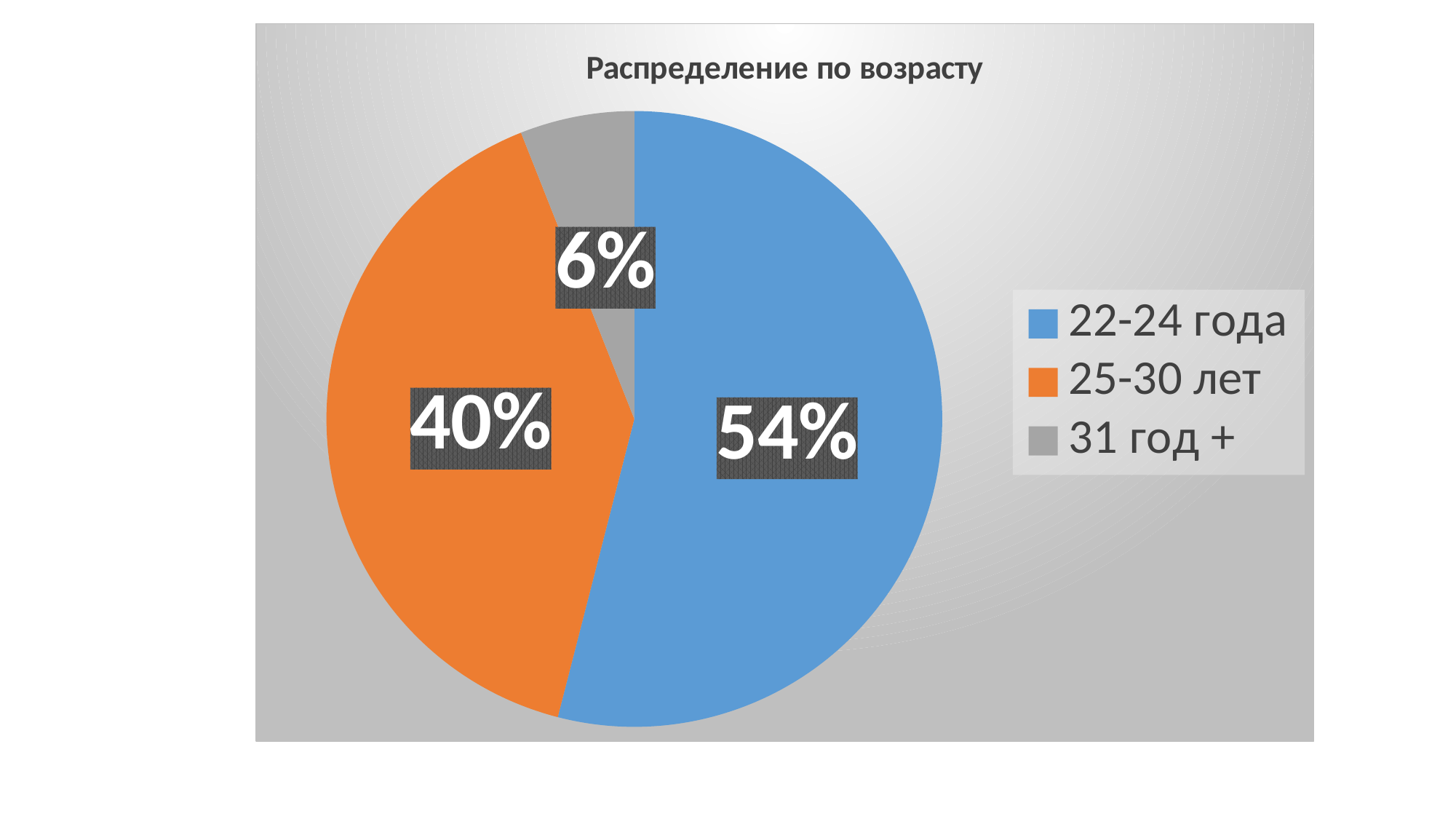
What is the difference in percentage points between the 25-30 лет and 31 год + slices? 34 What type of chart is shown on the slide? pie chart What is the difference in percentage points between the 22-24 года and 25-30 лет slices? 14 Which colour represents the 25-30 лет group in the legend? orange What share of the pie does the 25-30 лет slice have? 40% How many slices does the pie chart have? 3 Which age group has the largest share of the pie? 22-24 года Which age group has the smallest share of the pie? 31 год + Which slice is larger: 25-30 лет or 31 год +? 25-30 лет What share of the pie does the 22-24 года slice have? 54% What is the title of the chart? Распределение по возрасту What share of the pie does the 31 год + slice have? 6%